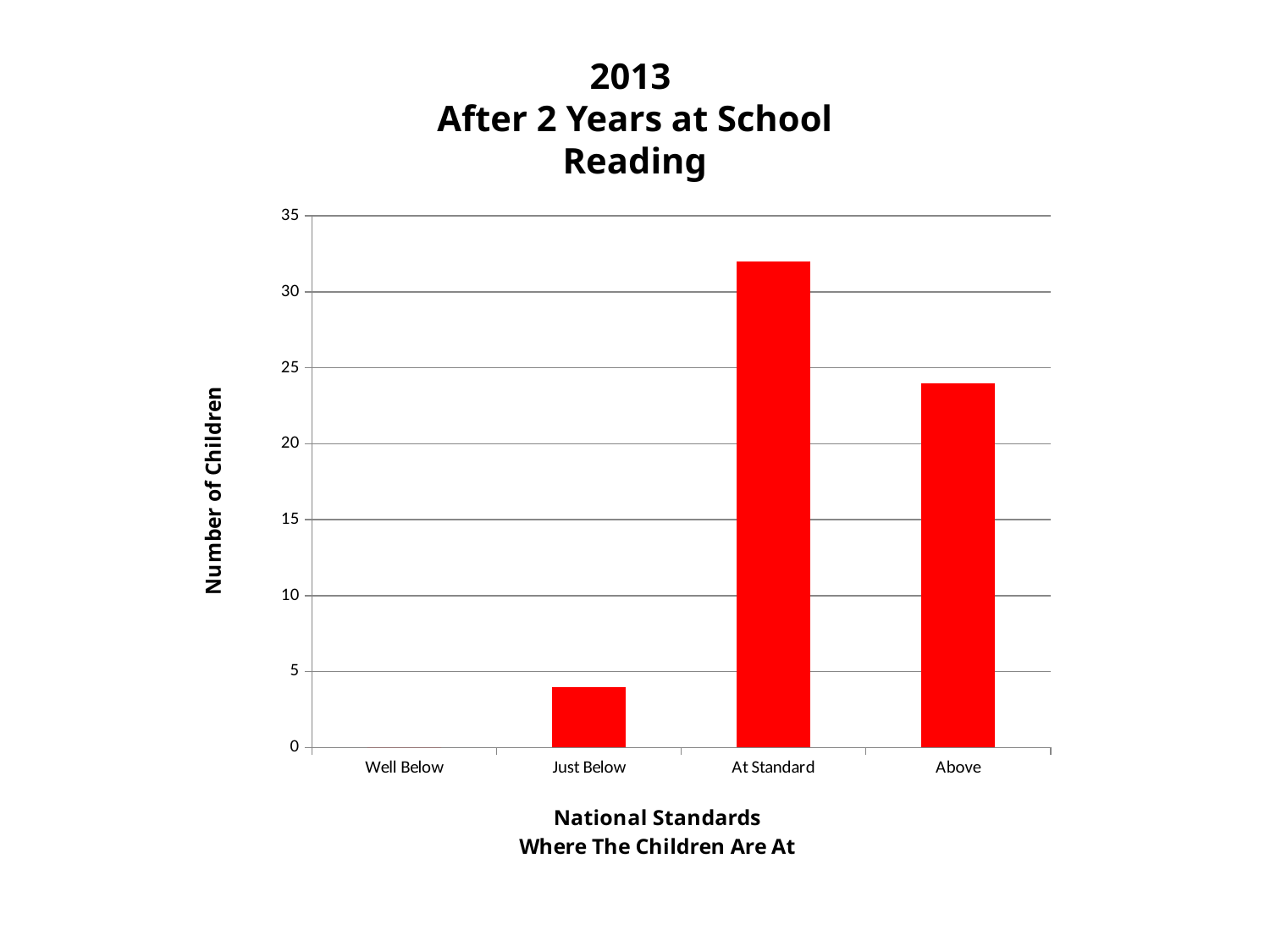
Is the value for Above greater or less than 25? less How many categories are shown on the x axis? 4 What is the label on the vertical axis? Number of Children What kind of chart is shown on the slide? bar chart Which category has the lowest number of children? Well Below Is the value for Just Below greater or less than 5? less Which has more children, Just Below or Above? Above Is the value for Above greater or less than 20? greater What is the title of the chart? 2013 After 2 Years at School Reading Which has more children, At Standard or Above? At Standard Which category has the highest number of children? At Standard